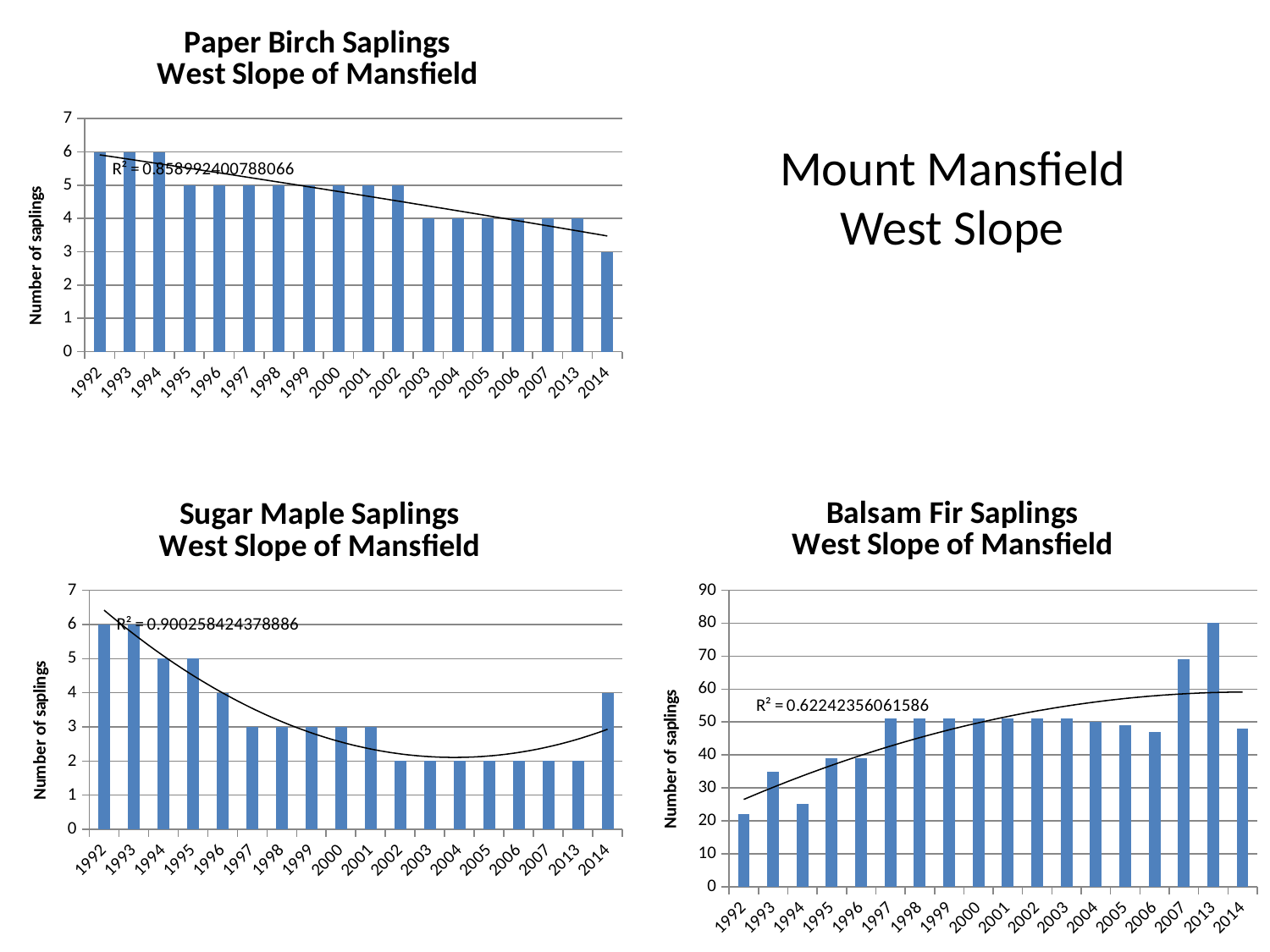
In the Paper Birch Saplings chart, what is the difference between the number of saplings in 1992 and in 2014? 3 In the Balsam Fir Saplings chart, is the value for 2007 greater or less than 60? greater In the Balsam Fir Saplings chart, is the value for 1992 greater or less than 30? less In the Sugar Maple Saplings chart, is the number of saplings larger in 1995 or in 2002? 1995 In the Sugar Maple Saplings chart, what is the number of saplings in 2014? 4 In the Paper Birch Saplings chart, do the values generally rise or fall from 1992 to 2014? fall In the Paper Birch Saplings chart, which year has the lowest number of saplings? 2014 In the Sugar Maple Saplings chart, which year has the highest number of saplings? 1992 and 1993 (tied at 6) In the Paper Birch Saplings chart, what is the number of saplings in 2014? 3 How many charts are shown on the slide? 3 In the Paper Birch Saplings chart, what is the number of saplings in 1992? 6 In the Balsam Fir Saplings chart, which year has the highest number of saplings? 2013